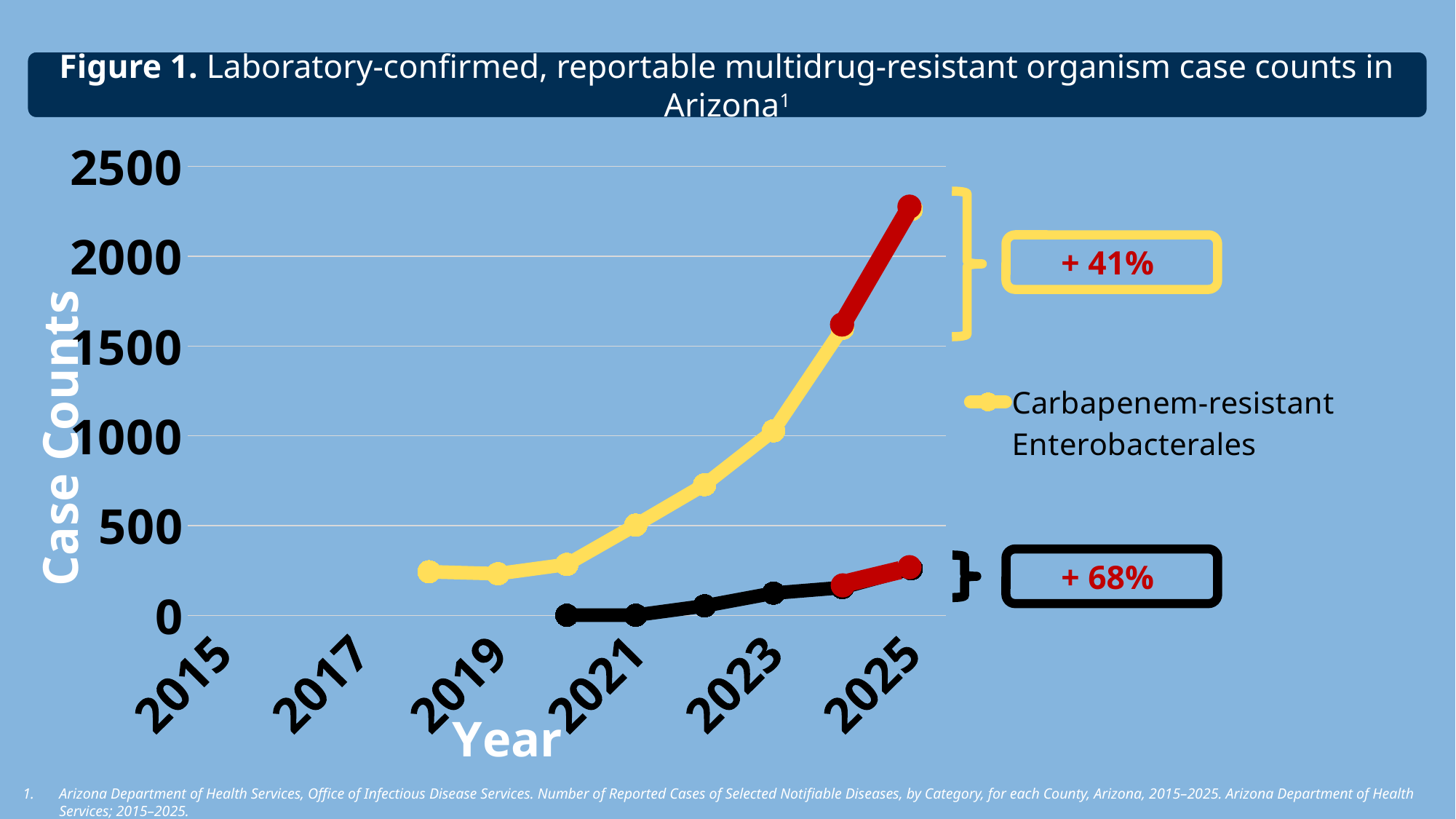
What percentage change is annotated for the Carbapenem-resistant Enterobacterales line? + 41% What is the title of the chart? Figure 1. Laboratory-confirmed, reportable multidrug-resistant organism case counts in Arizona In 2025, which line is higher: the Carbapenem-resistant Enterobacterales line or the black line? Carbapenem-resistant Enterobacterales In which year does the Carbapenem-resistant Enterobacterales line reach its highest value? 2025 How many year labels are shown on the x axis? 6 What percentage change is annotated for the lower black line? + 68% What series name is shown in the chart legend? Carbapenem-resistant Enterobacterales Is the value of the black line for 2025 greater or less than 500? less Is the Carbapenem-resistant Enterobacterales value for 2025 greater or less than 2000? greater What kind of chart is shown on the slide? line chart Is the Carbapenem-resistant Enterobacterales value for 2019 greater or less than 500? less Do the Carbapenem-resistant Enterobacterales case counts rise or fall from 2019 to 2025? rise